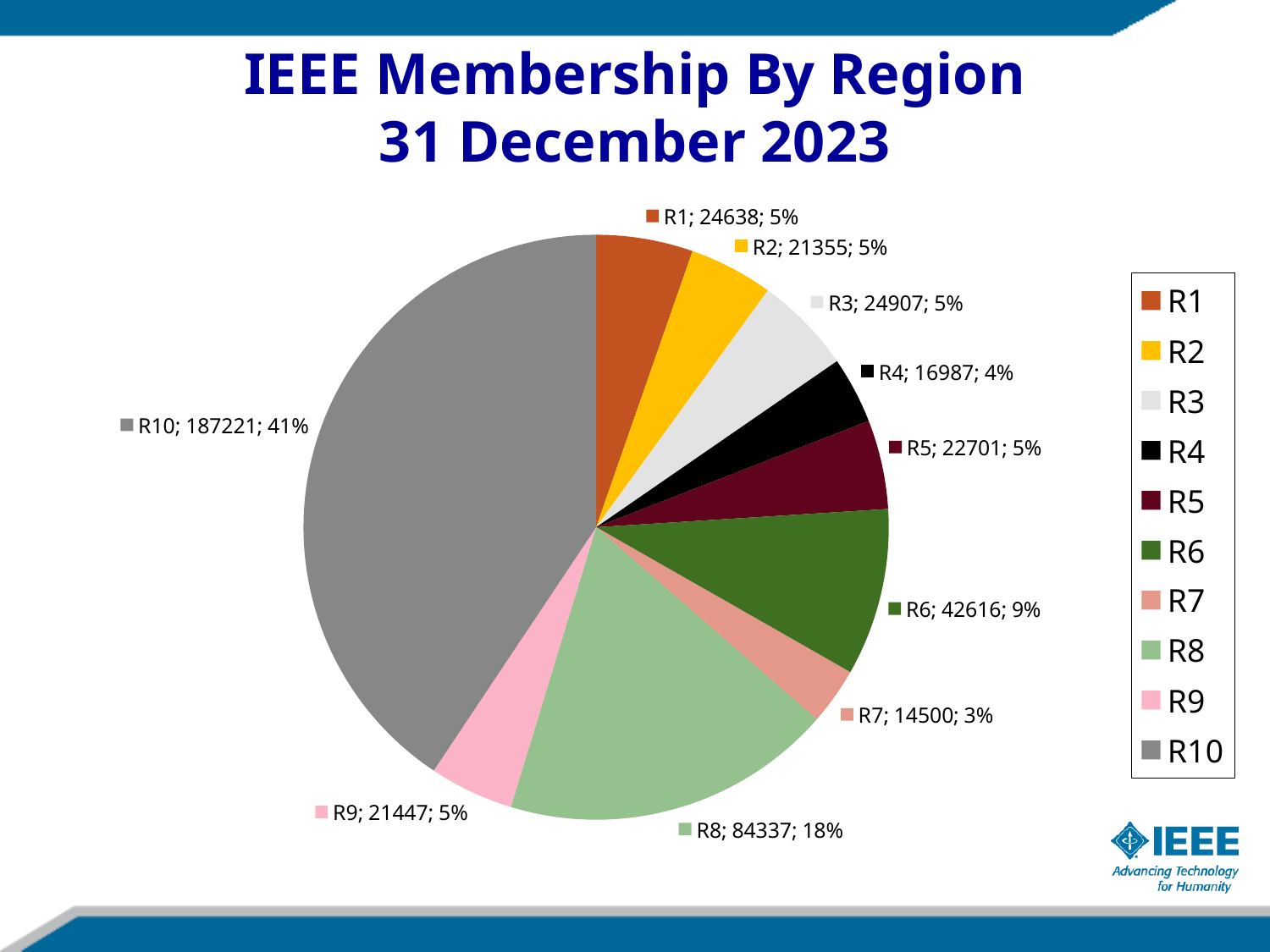
What is the title of the chart? IEEE Membership By Region 31 December 2023 What is the membership value for R8? 84337 Which has a larger membership, R1 or R2? R1 What is the membership value for R10? 187221 What share of the pie does R8 represent? 18% Which region has the smallest membership? R7 What is the difference in membership between R6 and R7? 28116 What kind of chart is shown on the slide? pie chart How many regions are shown in the pie chart? 10 Which region has the largest membership? R10 What share of the pie does R6 represent? 9% What is the membership value for R4? 16987